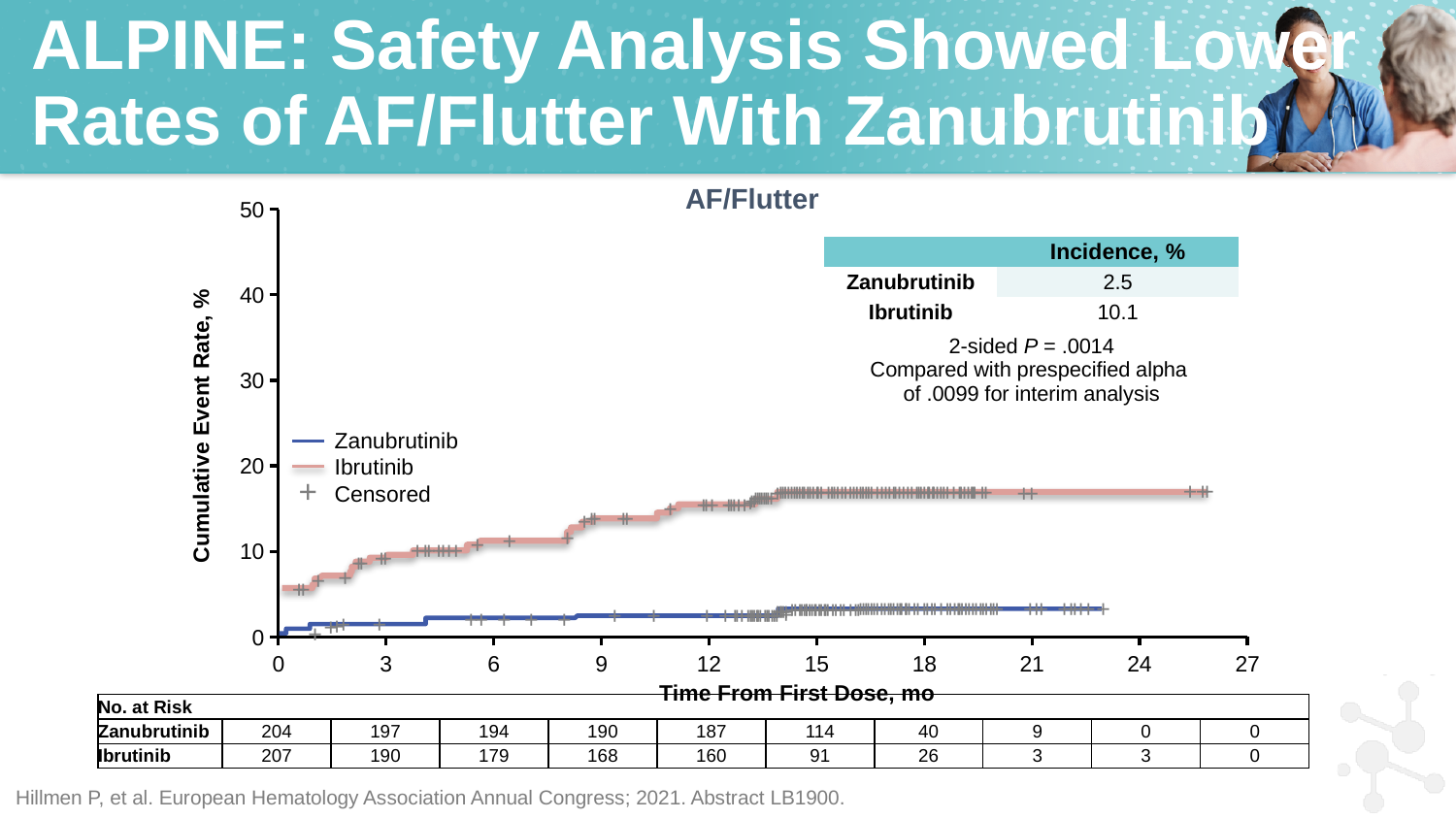
What is the number at risk for Zanubrutinib at time 0? 204 What is the number at risk for Ibrutinib at 15 months? 91 What kind of chart is shown on the slide? Line chart Is the cumulative event rate for Zanubrutinib at 18 months greater or less than 10? less Is the cumulative event rate for Ibrutinib at 24 months greater or less than 10? greater How many entries does the chart legend list? 3 What is the difference in incidence, %, between Ibrutinib and Zanubrutinib? 7.6 Which treatment has the higher incidence of AF/Flutter, Zanubrutinib or Ibrutinib? Ibrutinib What is the incidence, %, for Zanubrutinib shown in the inset table? 2.5 Does the cumulative event rate for Ibrutinib rise or fall as time from first dose increases? Rise What is the incidence, %, for Ibrutinib shown in the inset table? 10.1 What is the title of the chart? AF/Flutter